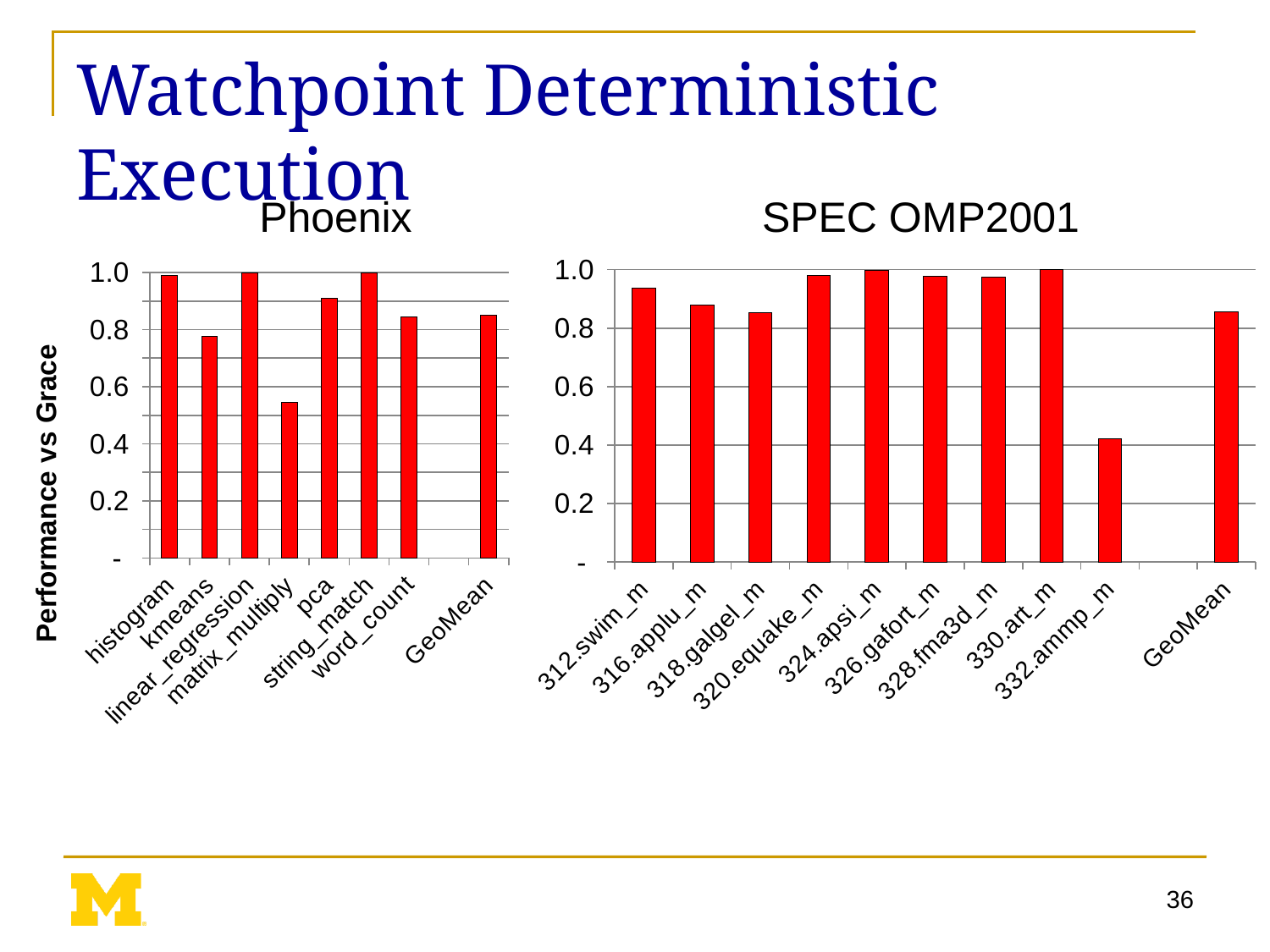
On the SPEC OMP2001 chart, which is larger, the value for 312.swim_m or the value for 332.ammp_m? 312.swim_m What is the label on the vertical axis of the Phoenix chart? Performance vs Grace On the Phoenix chart, is the value for matrix_multiply greater or less than 0.6? less On the SPEC OMP2001 chart, is the value for 312.swim_m greater or less than 0.8? greater On the Phoenix chart, is the value for pca greater or less than 0.8? greater How many categories are shown on the SPEC OMP2001 chart? 10 On the SPEC OMP2001 chart, which category has the lowest value? 332.ammp_m On the Phoenix chart, which category has the lowest value? matrix_multiply What kind of chart is the Phoenix chart? bar chart On the Phoenix chart, which is larger, the value for kmeans or the value for matrix_multiply? kmeans How many categories are shown on the Phoenix chart? 8